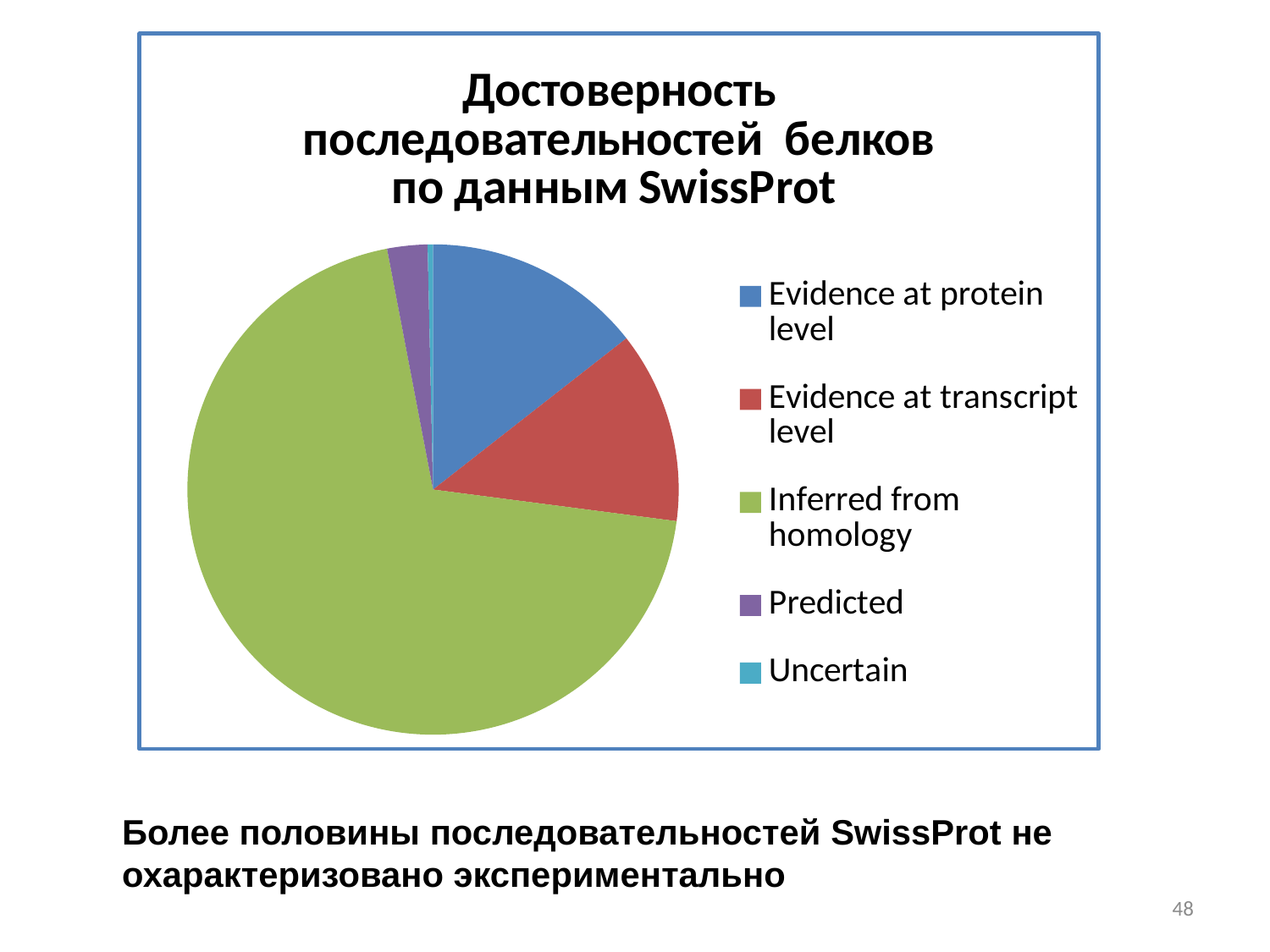
What colour is the Inferred from homology slice? green Which legend entry is shown in blue? Evidence at protein level Does the Inferred from homology slice take up more or less than half of the pie? more Which slice is larger: Evidence at transcript level or Uncertain? Evidence at transcript level Which slice is larger: Evidence at protein level or Predicted? Evidence at protein level How many categories does the pie chart show? 5 How many entries does the legend list? 5 Which slice is larger: Inferred from homology or Evidence at protein level? Inferred from homology Which category has the largest slice of the pie? Inferred from homology What kind of chart is shown on the slide? pie chart Which category has the smallest slice of the pie? Uncertain